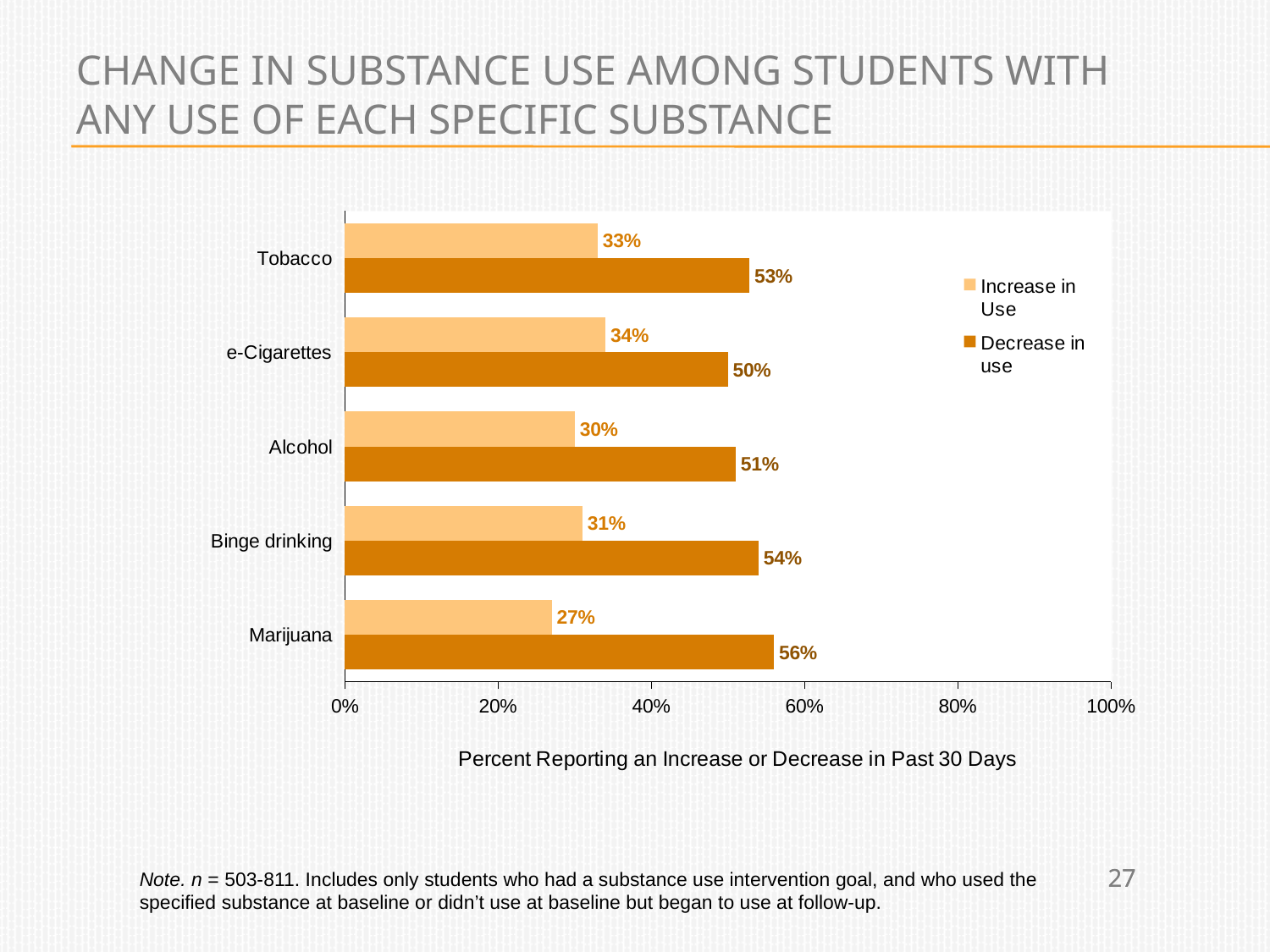
What percent of students reported an increase in use of Tobacco? 33% Is the 'Decrease in use' value for Tobacco greater or less than 40%? greater How many substances are shown on the chart? 5 What is the label on the horizontal axis of the chart? Percent Reporting an Increase or Decrease in Past 30 Days What percent of students reported a decrease in use of Marijuana? 56% What kind of chart is shown on the slide? Bar chart Which substance has the highest 'Decrease in use' value? Marijuana What is the 'Decrease in use' value for e-Cigarettes? 50% How many series does the legend list? 2 Which is larger for Alcohol: the 'Increase in Use' value or the 'Decrease in use' value? Decrease in use What is the difference between the 'Decrease in use' and 'Increase in Use' values for Binge drinking? 23% Which substance has the lowest 'Increase in Use' value? Marijuana